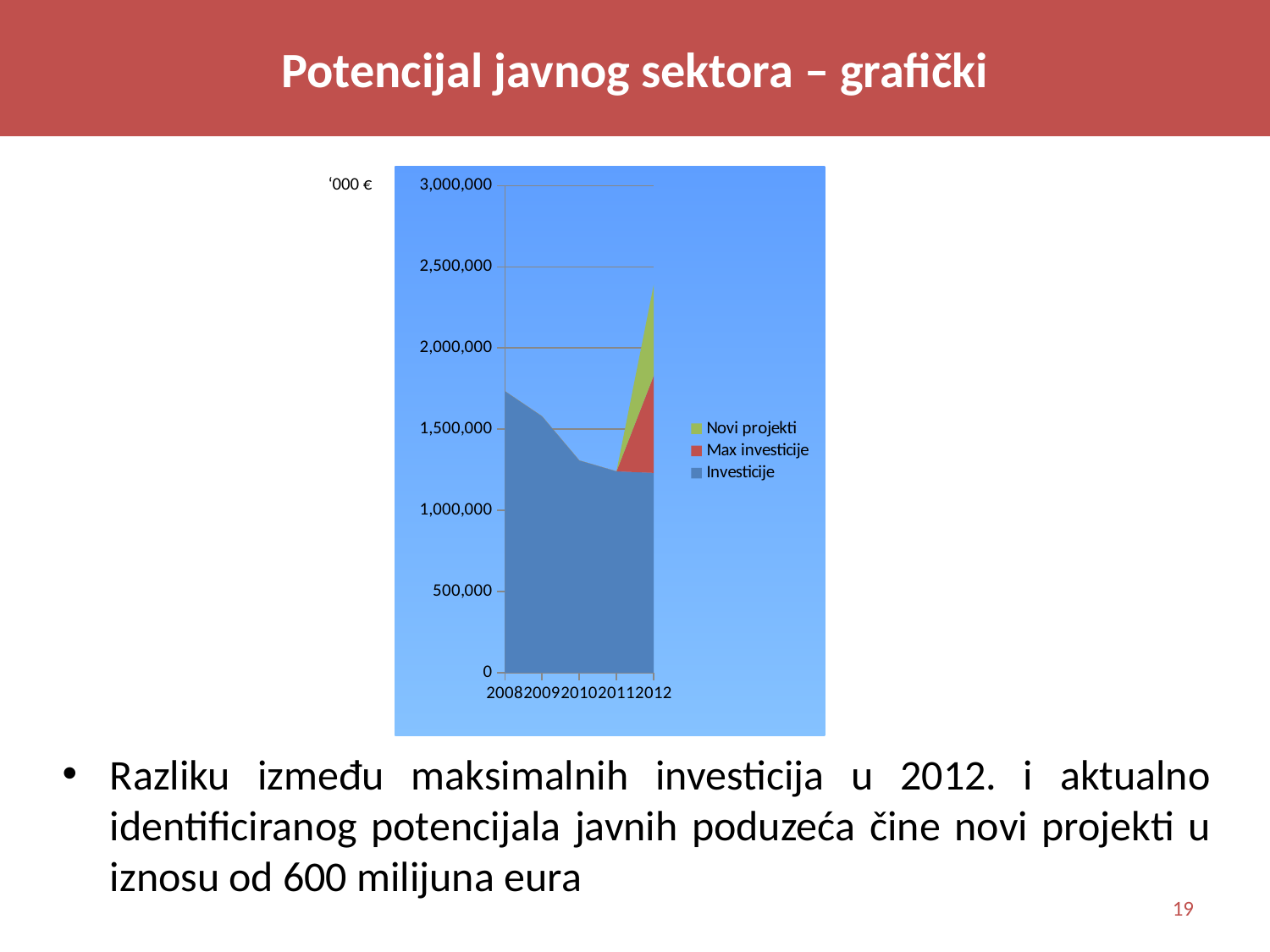
Is the total stacked value in 2012 greater or less than 2,000,000? greater What kind of chart is shown on the slide? Area chart Which is larger for Investicije: the value in 2008 or the value in 2011? 2008 How many years are shown on the x axis of the chart? 5 Is the value for Investicije in 2011 greater or less than 1,500,000? less Is the value for Investicije in 2008 greater or less than 1,500,000? greater How many series does the chart legend list? 3 In which year is the Investicije series highest? 2008 What unit label is shown next to the vertical axis of the chart? '000 € Does the Investicije series rise or fall from 2008 to 2011? Fall Which series is shown in green in the chart legend? Novi projekti